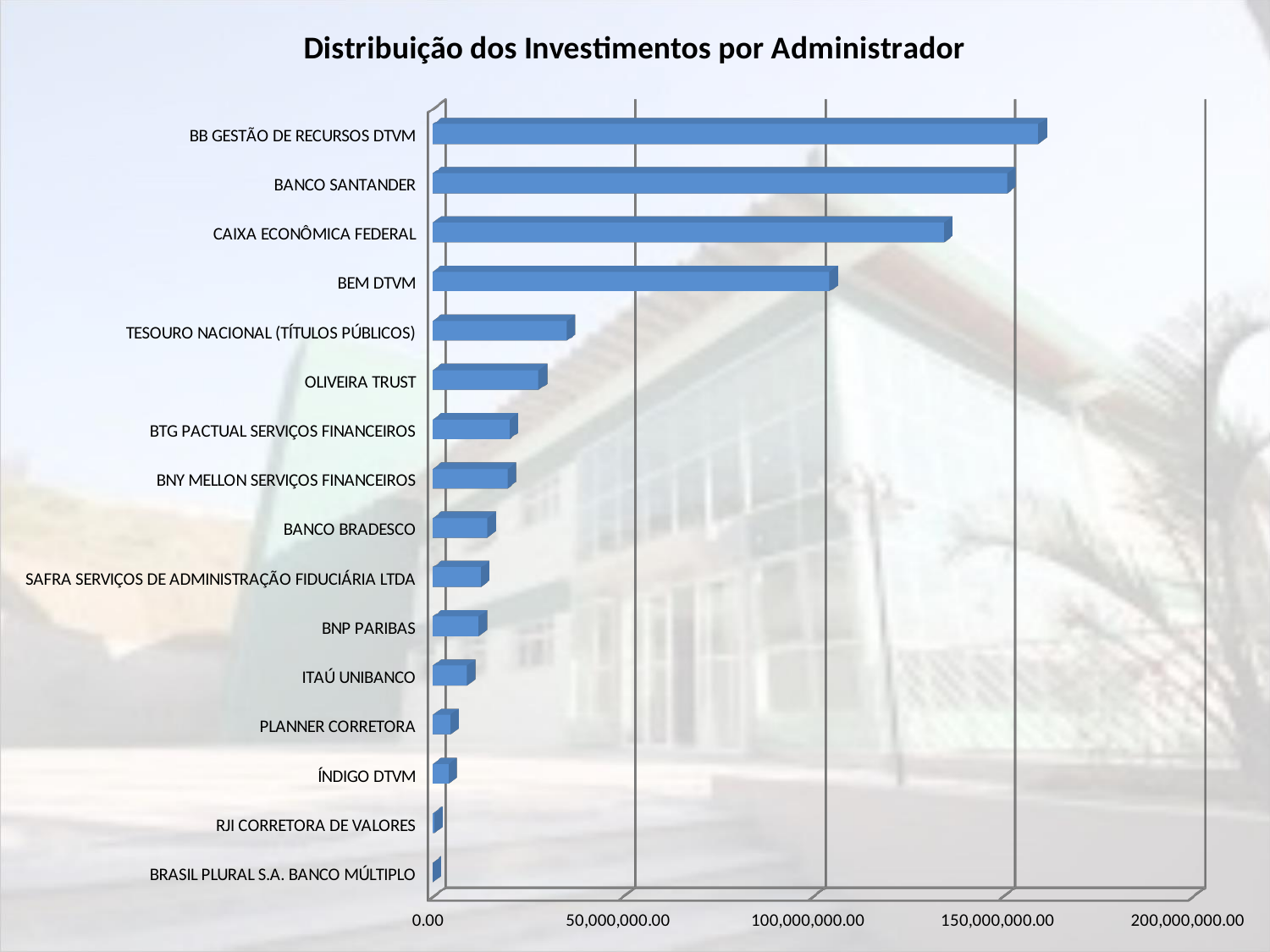
Which has a larger value, CAIXA ECONÔMICA FEDERAL or BEM DTVM? CAIXA ECONÔMICA FEDERAL Is the value for BEM DTVM greater or less than 150,000,000.00? less Is the value for CAIXA ECONÔMICA FEDERAL greater or less than 100,000,000.00? greater Which has a larger value, TESOURO NACIONAL (TÍTULOS PÚBLICOS) or OLIVEIRA TRUST? TESOURO NACIONAL (TÍTULOS PÚBLICOS) Do the bar values increase or decrease going from the top of the chart to the bottom? decrease Which administrator has the highest investment value? BB GESTÃO DE RECURSOS DTVM Is the value for CAIXA ECONÔMICA FEDERAL greater or less than 150,000,000.00? less How many administrators (categories) are plotted in the chart? 16 What is the title of the chart? Distribuição dos Investimentos por Administrador What type of chart is shown on the slide? Bar chart